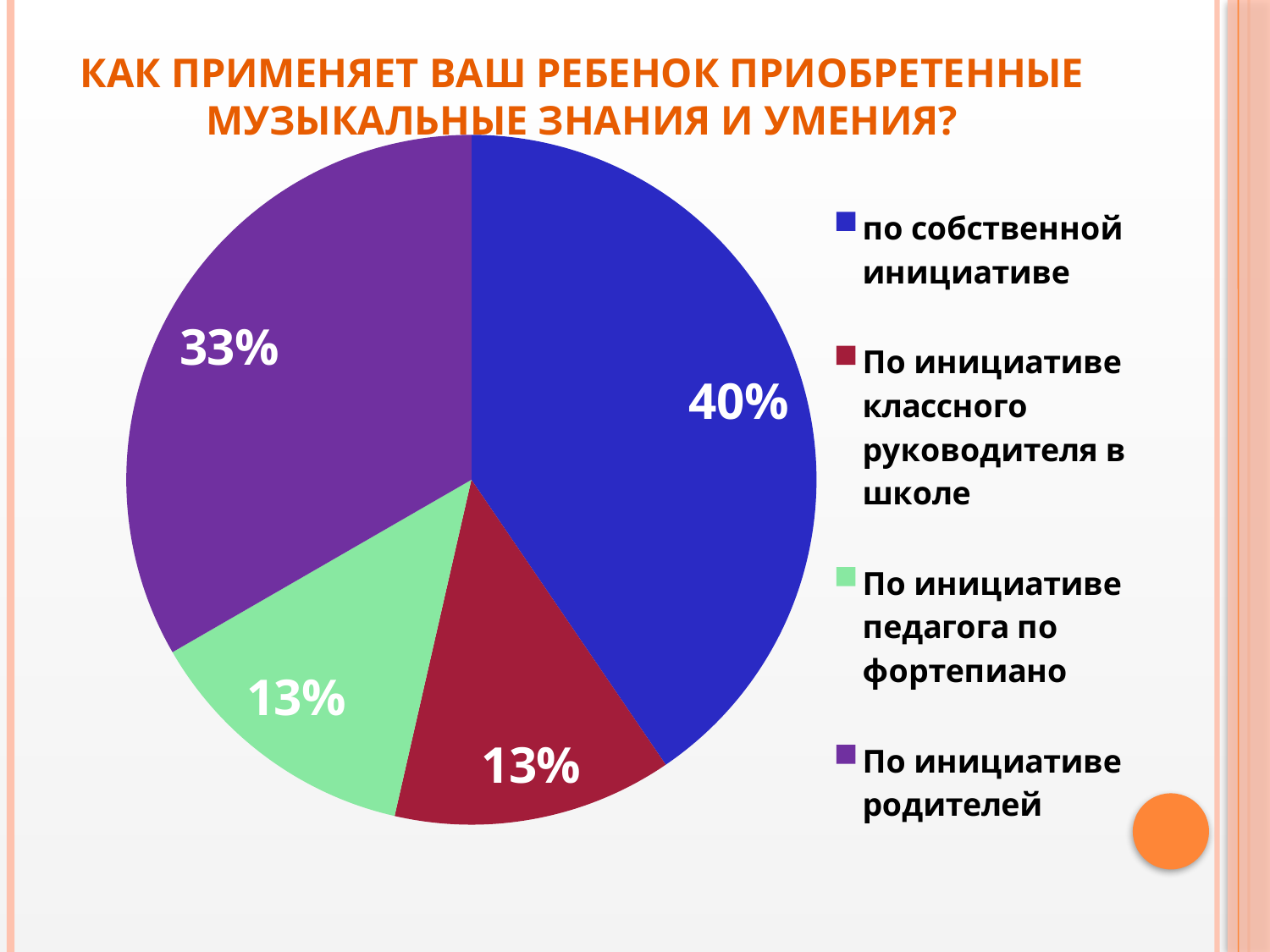
Which category has the largest share of the pie? по собственной инициативе How many slices does the pie chart have? 4 What percentage is shown for "По инициативе педагога по фортепиано"? 13% What colour is the slice for "По инициативе родителей"? purple What percentage is shown for "По инициативе классного руководителя в школе"? 13% Which is larger: the share for "По инициативе родителей" or the share for "По инициативе педагога по фортепиано"? По инициативе родителей What percentage is shown for "По инициативе родителей"? 33% What kind of chart is shown on the slide? pie chart What percentage is shown for "по собственной инициативе"? 40% What is the difference between the shares for "по собственной инициативе" and "По инициативе родителей"? 7% How many entries does the legend list? 4 What is the title of the chart? Как применяет ваш ребенок приобретенные музыкальные знания и умения?